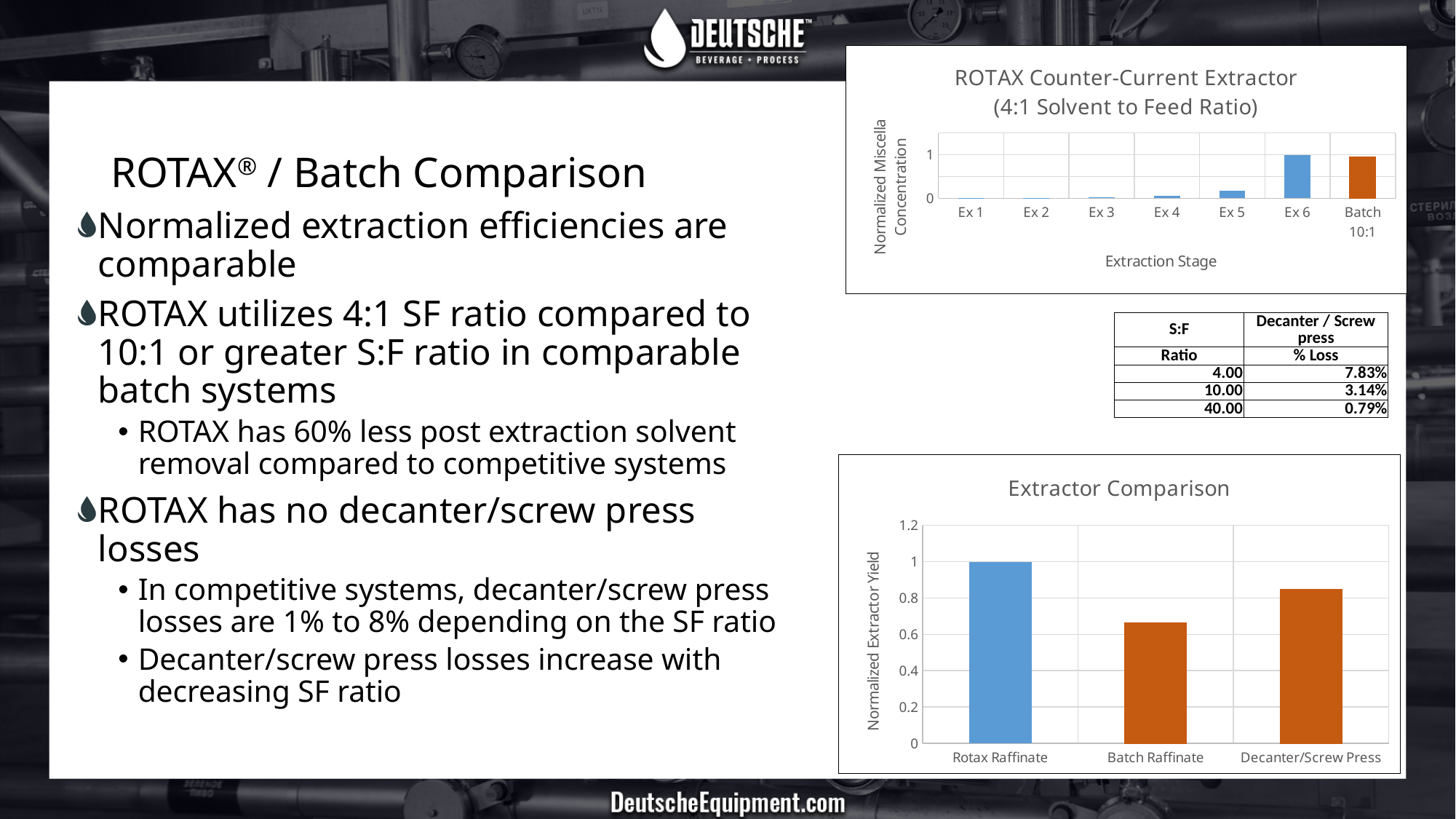
What kind of chart is the "Extractor Comparison" chart? bar chart In the "Extractor Comparison" chart, which category has the highest normalized extractor yield? Rotax Raffinate In the "Extractor Comparison" chart, what is the normalized extractor yield for Rotax Raffinate? 1 In the "Extractor Comparison" chart, which category has the lowest normalized extractor yield? Batch Raffinate In the "ROTAX Counter-Current Extractor" chart, do the values rise or fall from Ex 1 to Ex 6? rise In the "Extractor Comparison" chart, is the value for Decanter/Screw Press greater or less than 0.8? greater In the "Extractor Comparison" chart, how many categories are shown on the x axis? 3 In the "Extractor Comparison" chart, is the value for Batch Raffinate greater or less than 0.8? less In the "ROTAX Counter-Current Extractor" chart, how many extraction stages are shown on the x axis? 7 In the "ROTAX Counter-Current Extractor" chart, which extraction stage has the highest normalized miscella concentration? Ex 6 In the "Extractor Comparison" chart, what is the label of the y axis? Normalized Extractor Yield In the "Extractor Comparison" chart, which is larger: Batch Raffinate or Decanter/Screw Press? Decanter/Screw Press